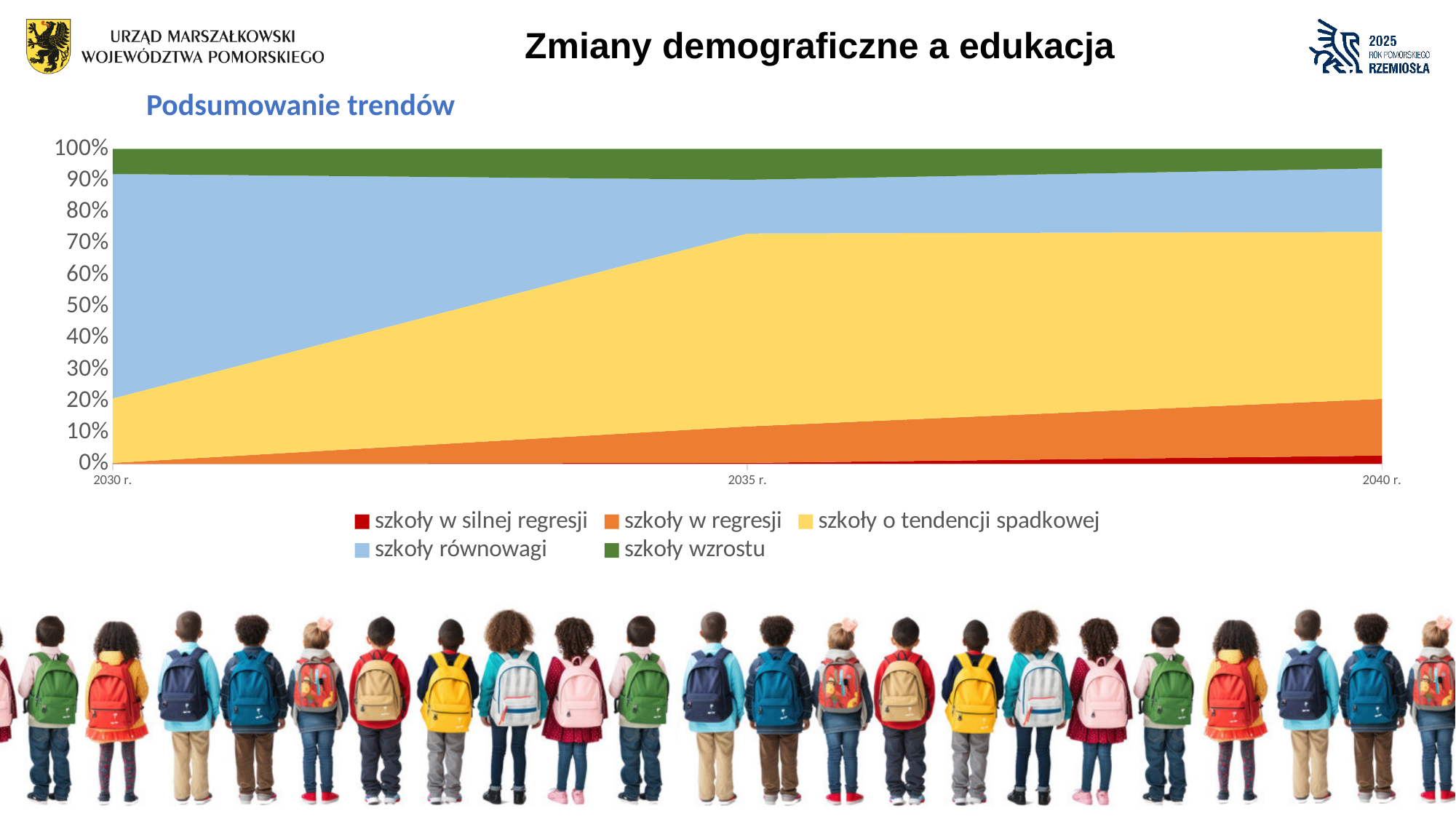
What is the title of the chart? Podsumowanie trendów Which series has the largest share in 2040 r.? szkoły o tendencji spadkowej Does the share of 'szkoły równowagi' rise or fall from 2030 r. to 2040 r.? fall How many series does the legend list? 5 Is the share of 'szkoły równowagi' in 2030 r. greater or less than 50%? greater Which series has the smallest share in 2030 r.? szkoły w silnej regresji Which colour represents 'szkoły wzrostu' in the legend? green How many year labels are shown on the x axis? 3 What kind of chart is shown on the slide? area chart Which series has the largest share in 2030 r.? szkoły równowagi In 2040 r., which is larger: the share of 'szkoły o tendencji spadkowej' or 'szkoły równowagi'? szkoły o tendencji spadkowej Does the share of 'szkoły o tendencji spadkowej' rise or fall from 2030 r. to 2040 r.? rise